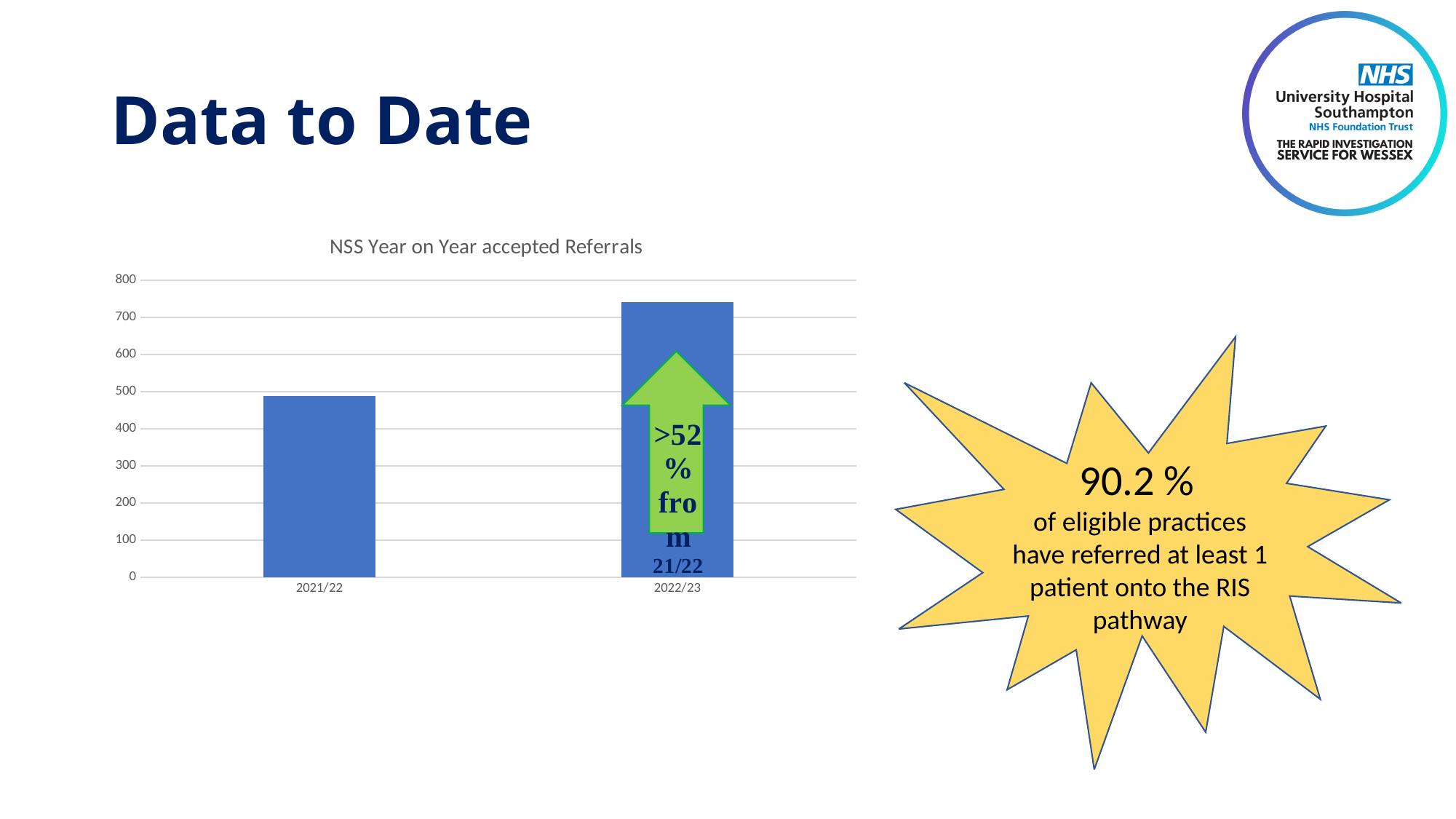
What kind of chart is shown on the slide? bar chart Is the value for 2022/23 greater or less than 700? greater How many categories are plotted on the x axis of the chart? 2 Which year has the highest number of accepted referrals? 2022/23 Is the value for 2021/22 greater or less than 400? greater Which is larger, the value for 2021/22 or the value for 2022/23? 2022/23 What percentage increase from 21/22 does the green arrow annotation on the chart state? >52% Do the accepted referrals rise or fall from 2021/22 to 2022/23? rise What is the title of the chart? NSS Year on Year accepted Referrals Is the value for 2021/22 greater or less than 600? less Which year has the lowest number of accepted referrals? 2021/22